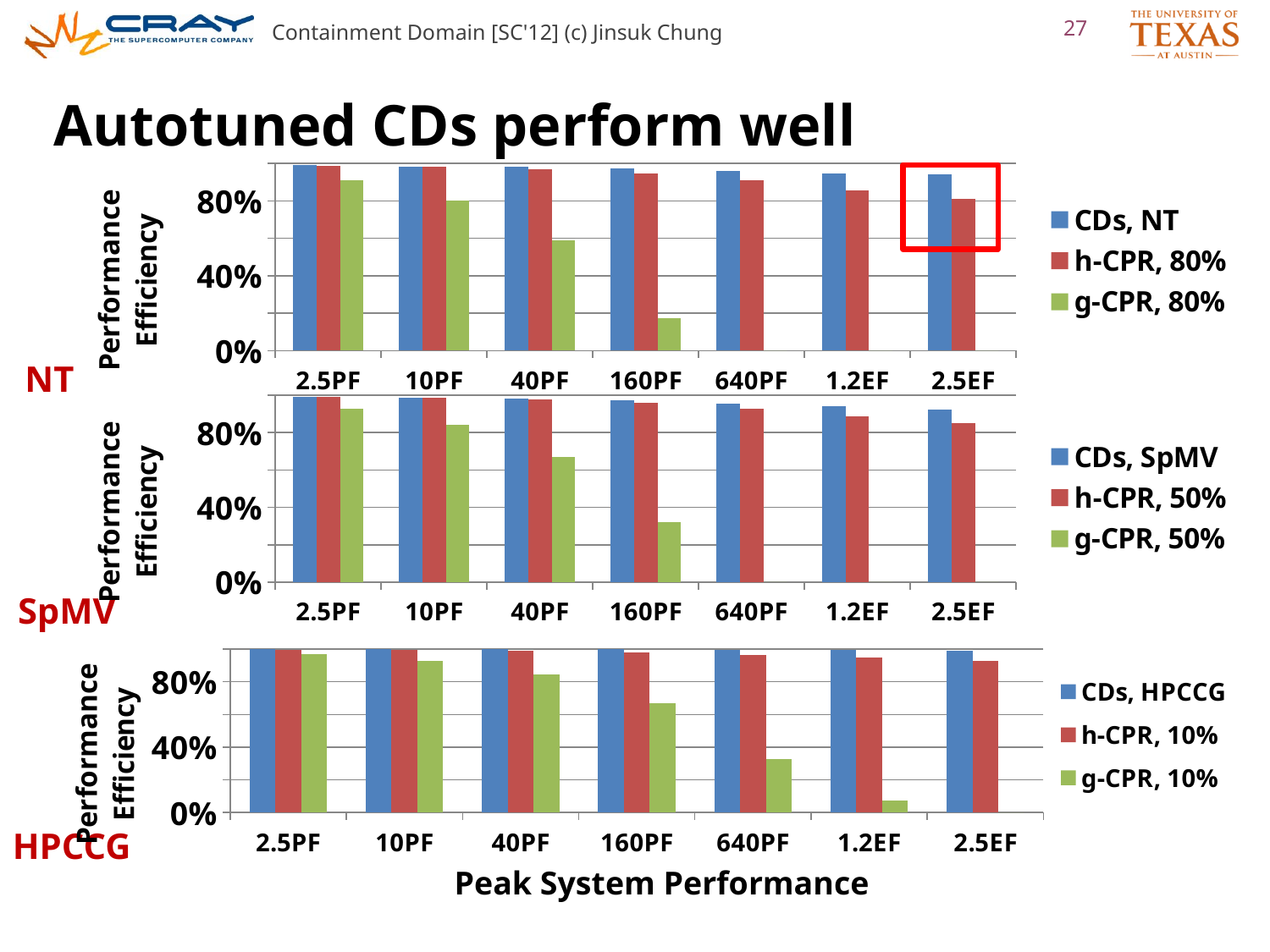
In the bottom chart (HPCCG), does the g-CPR, 10% series rise or fall as peak system performance increases along the x axis? fall What kind of chart is the top chart (NT)? bar chart In the bottom chart (HPCCG), is the value for g-CPR, 10% at 640PF greater or less than 40%? less In the middle chart (SpMV), is the value for g-CPR, 50% at 40PF greater or less than 80%? less In the middle chart (SpMV), which category has the lowest value for g-CPR, 50% among the categories where it is plotted? 160PF What is the x-axis title shown below the bottom chart (HPCCG)? Peak System Performance In the top chart (NT), is the value for g-CPR, 80% at 2.5PF greater or less than 80%? greater In the top chart (NT), how many peak system performance categories are shown on the x axis? 7 In the middle chart (SpMV), how many series does the legend list? 3 In the top chart (NT), at 160PF, which is larger: CDs, NT or g-CPR, 80%? CDs, NT In the bottom chart (HPCCG), what are the three legend entries? CDs, HPCCG; h-CPR, 10%; g-CPR, 10%